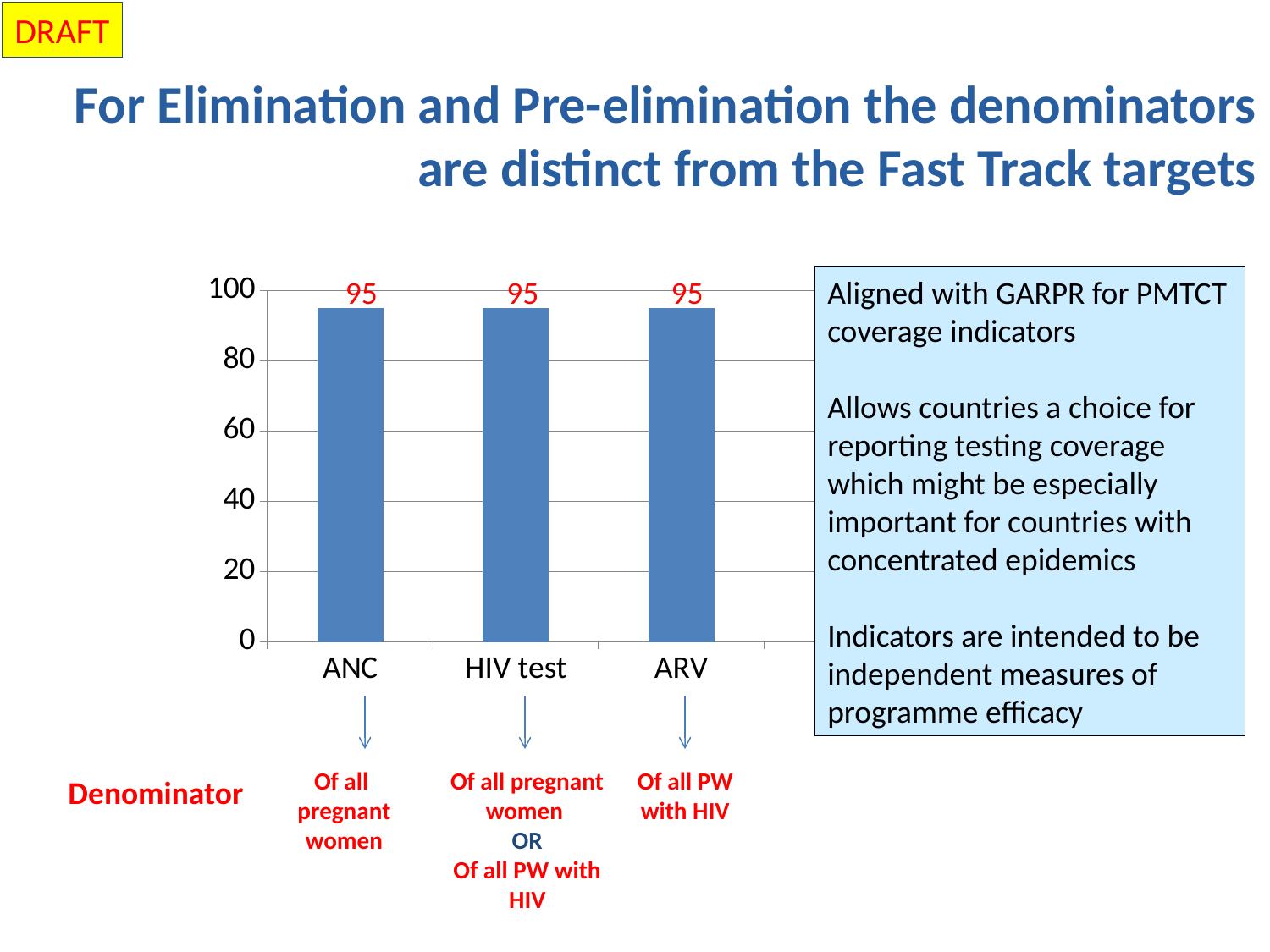
What is the value for ANC? 95 What kind of chart is shown on the slide? bar chart What is the denominator shown below the ARV bar? Of all PW with HIV What is the difference between the values for ANC and ARV? 0 How many categories are shown on the x axis of the chart? 3 Is the value for ANC greater or less than 100? less What is the value for ARV? 95 What is the highest value shown on the y axis of the chart? 100 Is the value for ARV greater or less than 80? greater Do the values rise, fall or stay the same across the categories from ANC to ARV? stay the same What is the value for HIV test? 95